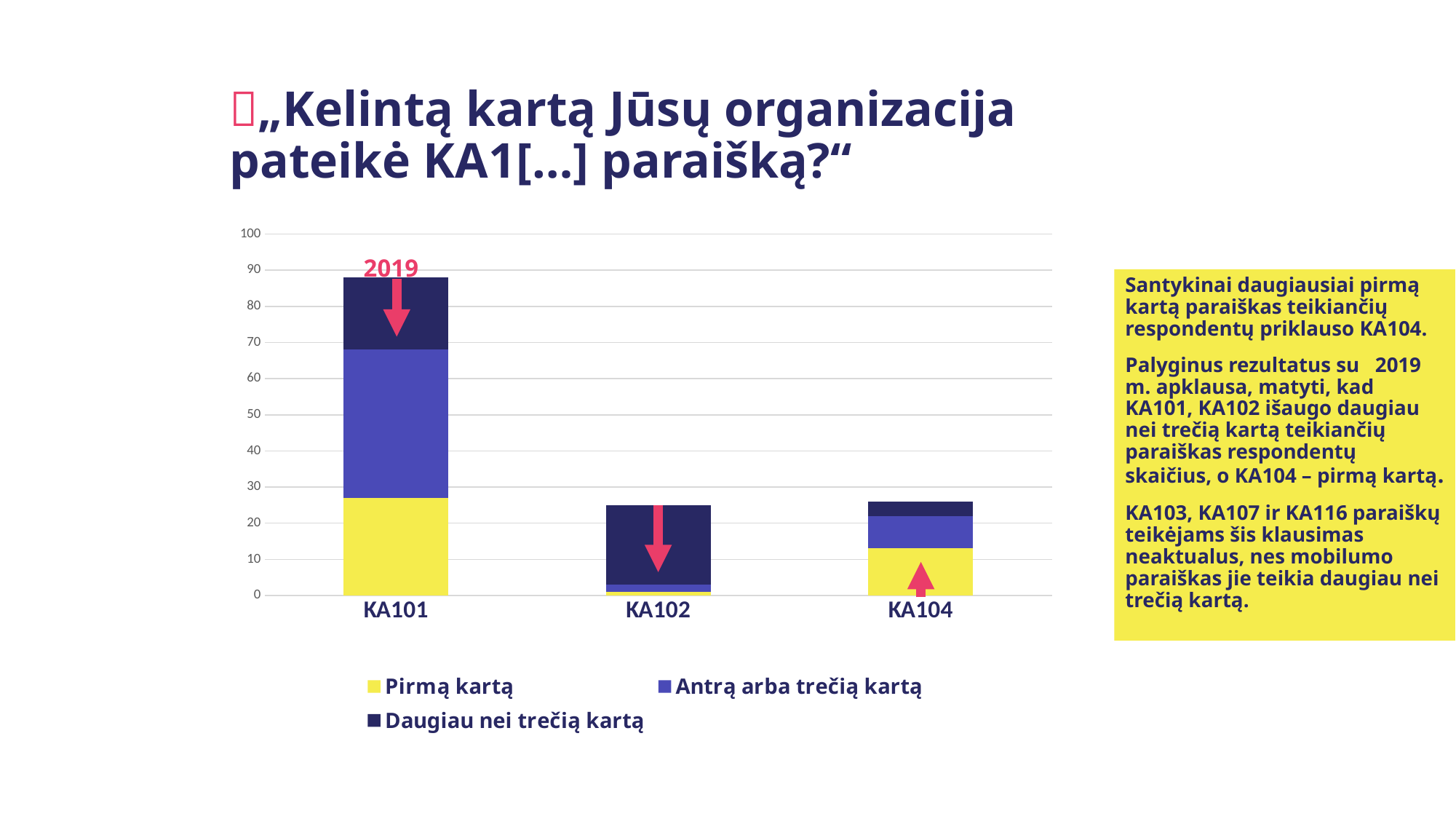
What kind of chart is shown on the slide? Stacked bar chart Is the total stacked bar for KA102 greater or less than 30? less Which has the larger 'Daugiau nei trečią kartą' value, KA102 or KA104? KA102 Is the 'Pirmą kartą' value for KA104 greater or less than 10? greater Which series is shown in yellow in the chart? Pirmą kartą How many categories are shown on the x axis of the chart? 3 Is the 'Pirmą kartą' value for KA101 greater or less than 20? greater Which category has the tallest stacked bar overall? KA101 Which has the larger 'Pirmą kartą' value, KA101 or KA104? KA101 Which category is labelled with the year 2019 and a downward arrow above its bar? KA101 How many series does the chart's legend list? 3